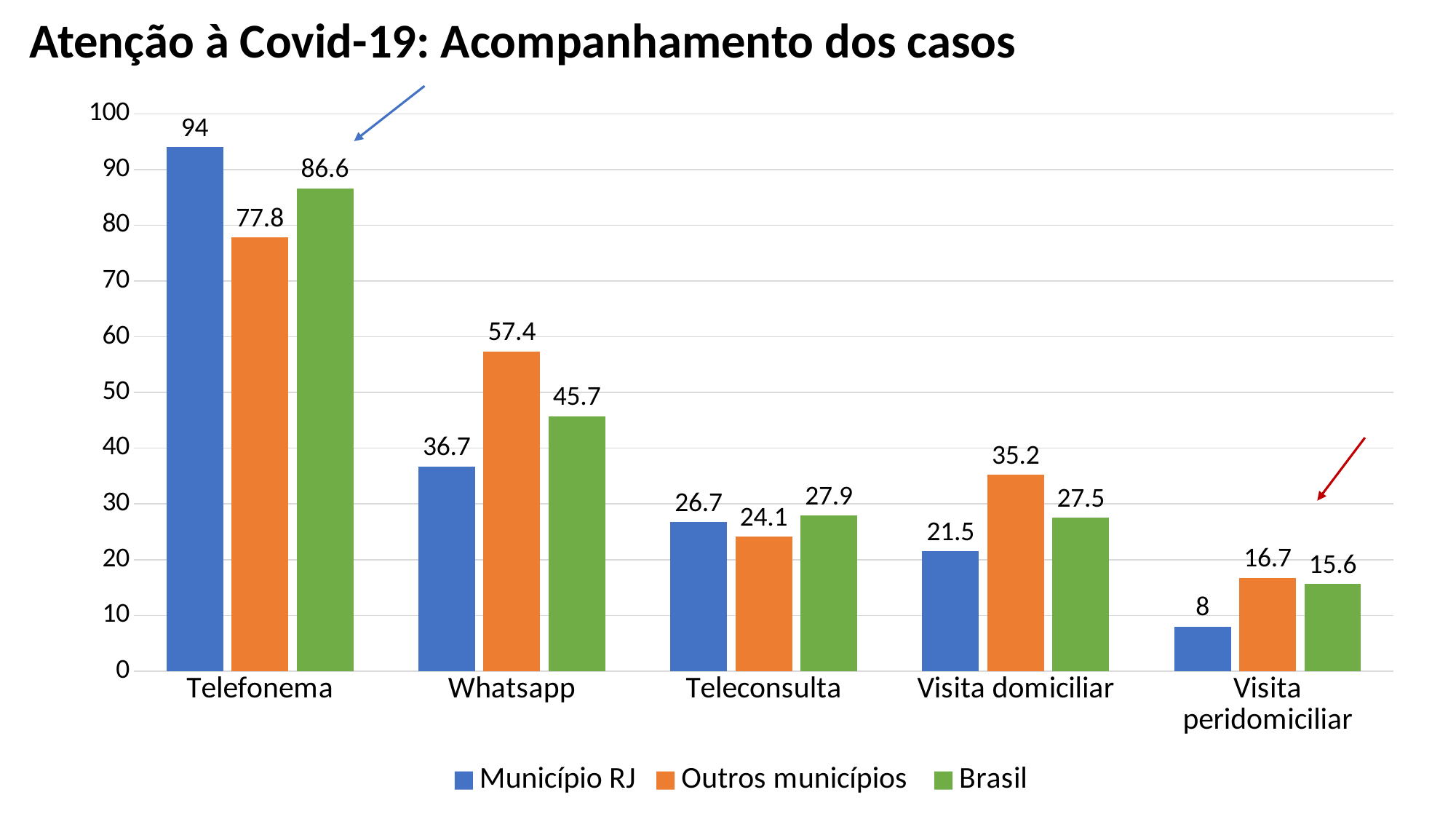
How many categories are shown on the x axis? 5 What is the value for Outros municípios in the Whatsapp category? 57.4 How many series does the legend list? 3 What is the value for Brasil in the Visita peridomiciliar category? 15.6 Is the value for Brasil in the Whatsapp category greater or less than 50? less Which category has the highest value for Município RJ? Telefonema What is the difference between the Município RJ and Brasil values in the Telefonema category? 7.4 What is the value for Município RJ in the Telefonema category? 94 What is the title of the chart? Atenção à Covid-19: Acompanhamento dos casos In the Visita domiciliar category, which is larger: Outros municípios or Brasil? Outros municípios What kind of chart is shown on the slide? bar chart Which category has the lowest value for Outros municípios? Visita peridomiciliar